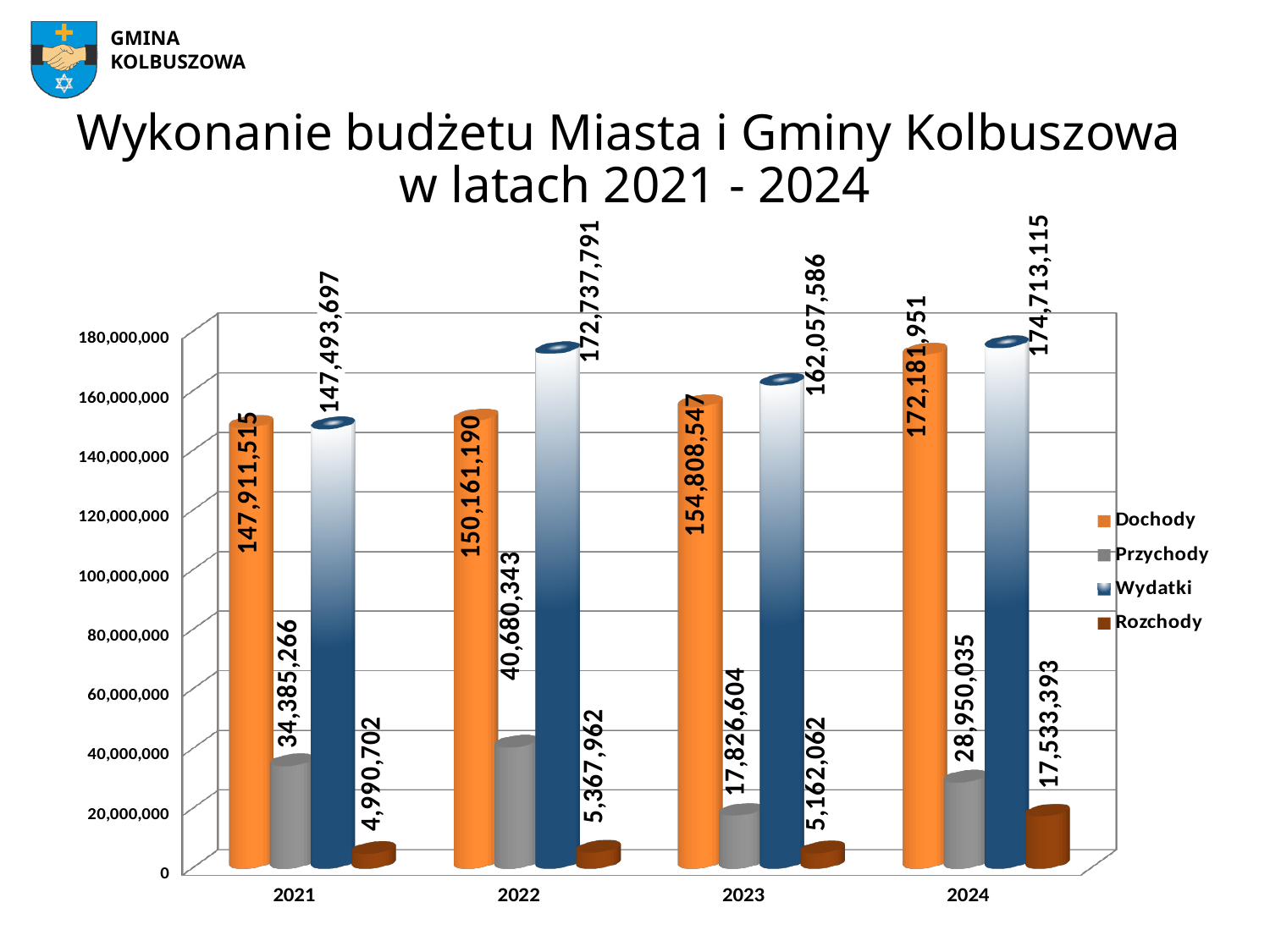
In which year is Wydatki the highest? 2024 What is the value of Przychody for 2023? 17,826,604 What type of chart is shown on the slide? Bar chart By how much did Dochody increase from 2021 to 2024? 24,270,436 What is the value of Rozchody for 2021? 4,990,702 In which year is Przychody the lowest? 2023 What is the value of Dochody for 2022? 150,161,190 How many series does the legend list? 4 Which is larger, Przychody in 2022 or Przychody in 2023? Przychody in 2022 What is the value of Wydatki for 2024? 174,713,115 What is the difference between Wydatki and Dochody in 2022? 22,576,601 Do the Dochody values rise or fall from 2021 to 2024? Rise